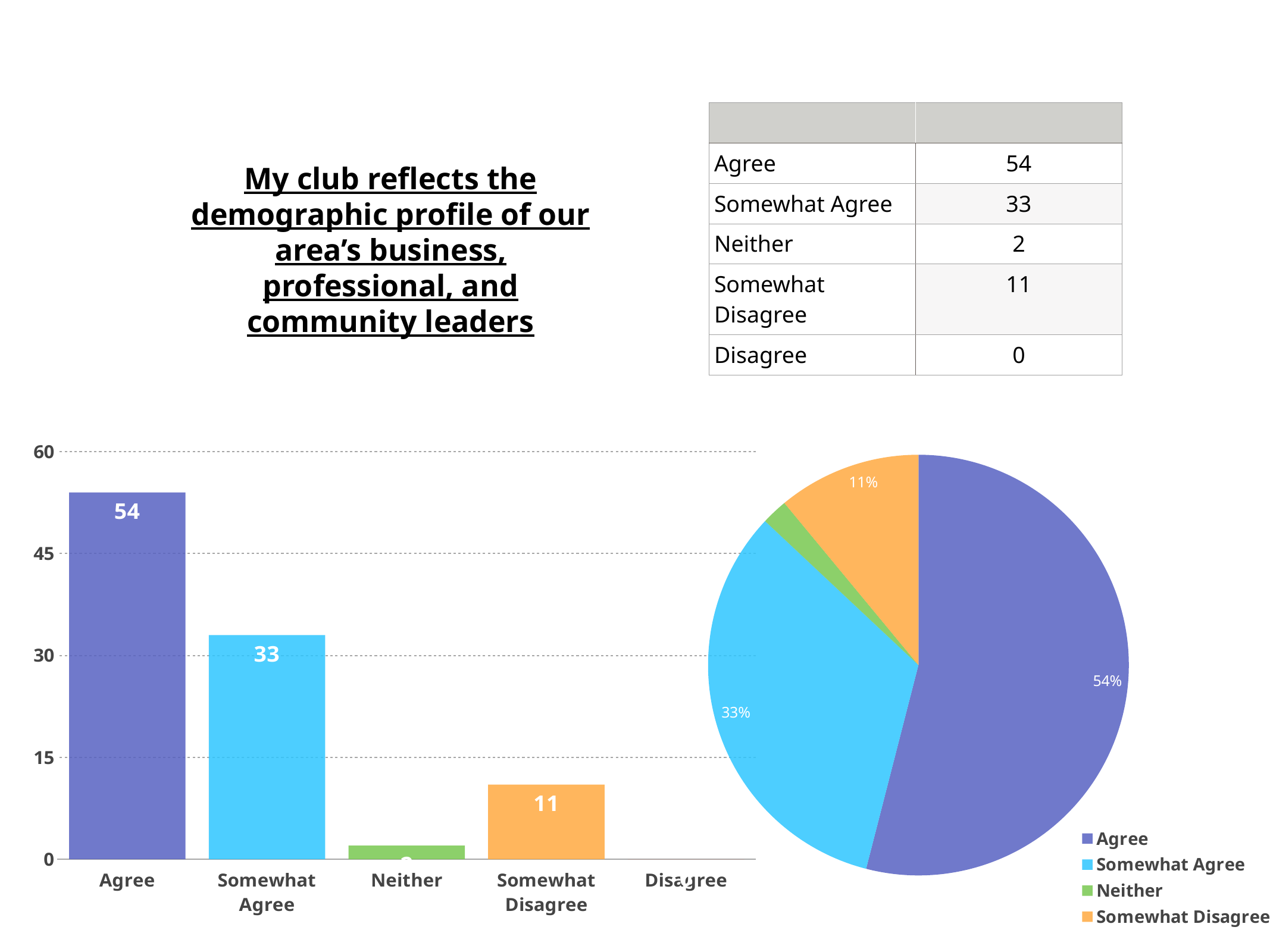
How many entries does the legend of the pie chart list? 4 In the bar chart, which category has the lowest value? Disagree How many categories are shown on the x axis of the bar chart? 5 In the bar chart, what is the value for Somewhat Disagree? 11 In the bar chart, which category has the highest value? Agree In the bar chart, what is the value for Agree? 54 In the pie chart, what share does the Agree slice have? 54% What kind of chart is shown at the bottom left of the slide? bar chart In the bar chart, is the value for Somewhat Agree greater or less than 30? greater In the bar chart, what is the difference between the values for Agree and Somewhat Agree? 21 In the pie chart, what share does the Somewhat Agree slice have? 33% In the bar chart, which is larger, the value for Somewhat Agree or the value for Somewhat Disagree? Somewhat Agree